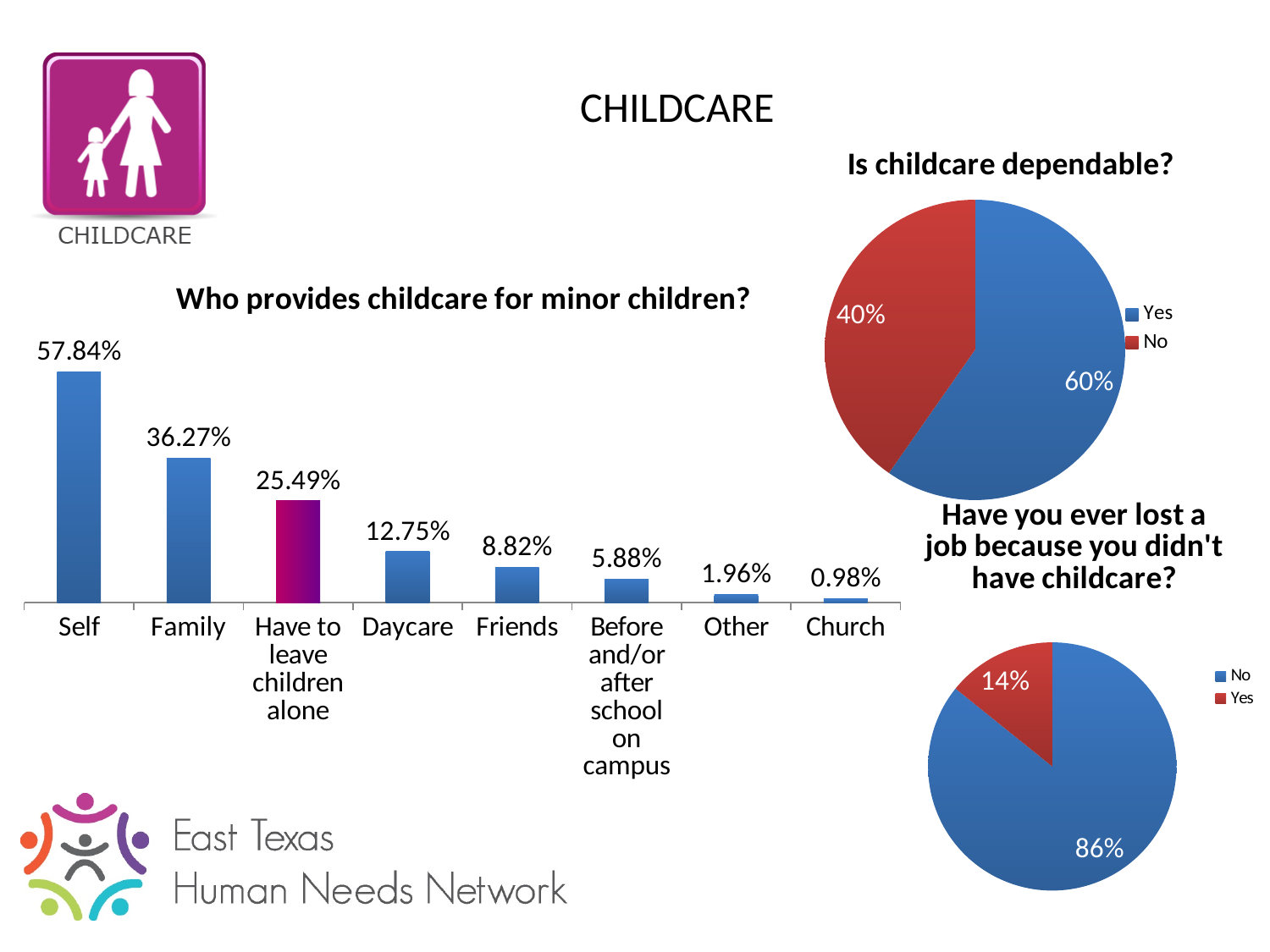
In the 'Who provides childcare for minor children?' chart, what is the value for Self? 57.84% In the 'Who provides childcare for minor children?' chart, what is the value for Daycare? 12.75% In the 'Have you ever lost a job because you didn't have childcare?' chart, what share of the pie is Yes? 14% In the 'Who provides childcare for minor children?' chart, which is larger, Friends or Before and/or after school on campus? Friends In the 'Have you ever lost a job because you didn't have childcare?' chart, which slice is larger, No or Yes? No How many categories are shown in the 'Who provides childcare for minor children?' chart? 8 In the 'Is childcare dependable?' chart, what share of the pie is Yes? 60% In the 'Who provides childcare for minor children?' chart, what is the difference between Self and Family? 21.57% What kind of chart is 'Who provides childcare for minor children?'? Bar chart In the 'Who provides childcare for minor children?' chart, which category has the highest value? Self In the 'Who provides childcare for minor children?' chart, which bar is coloured differently from the others? Have to leave children alone In the 'Who provides childcare for minor children?' chart, which category has the lowest value? Church